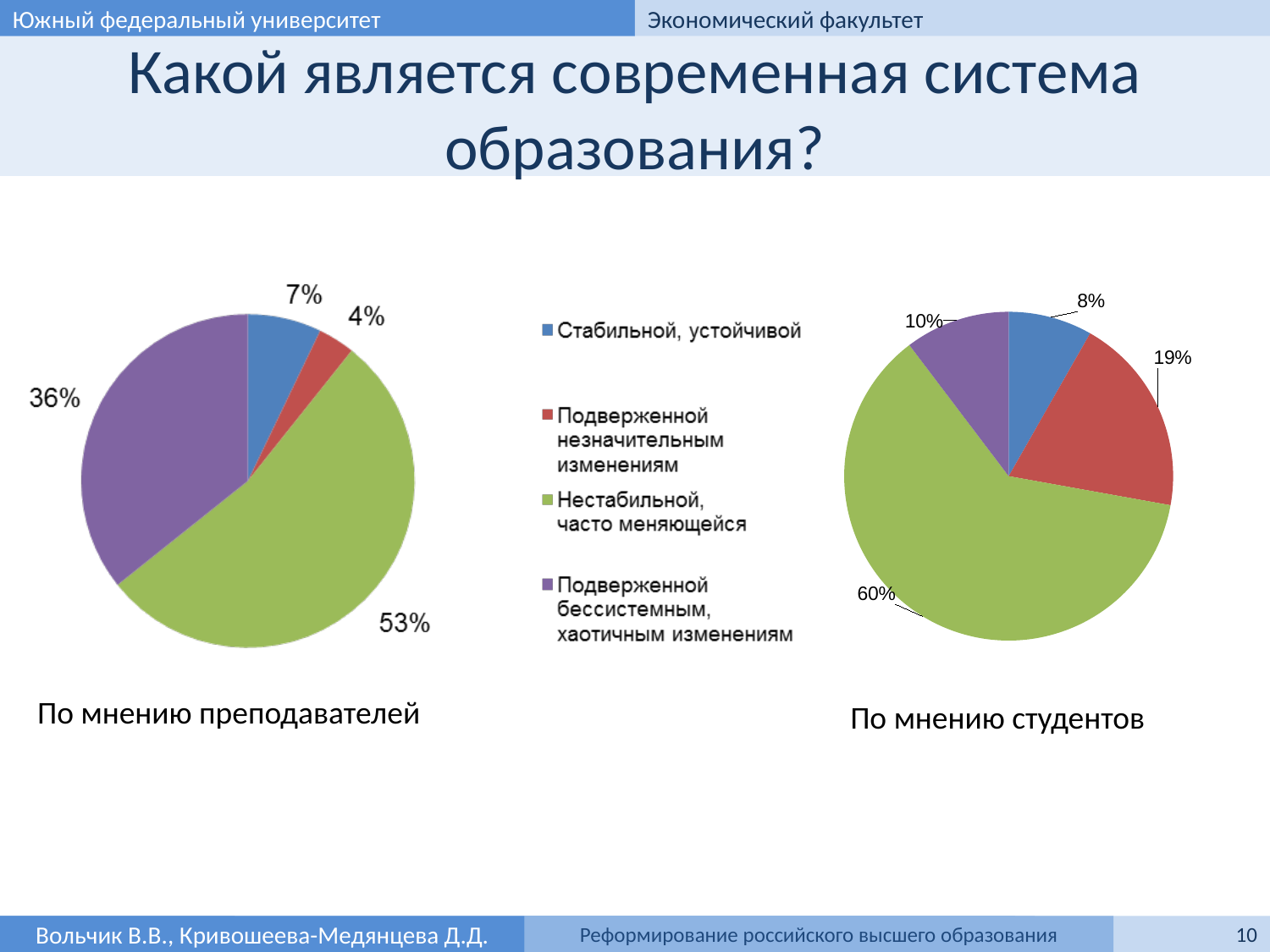
On the pie chart 'По мнению студентов', what share is labelled for the 'Подверженной бессистемным, хаотичным изменениям' slice? 10% What is the difference between the 'Нестабильной, часто меняющейся' share on the 'По мнению студентов' chart and on the 'По мнению преподавателей' chart? 7% What type of chart is used for 'По мнению преподавателей'? Pie chart How many slices does the pie chart 'По мнению студентов' have? 4 On the pie chart 'По мнению студентов', what share is labelled for the 'Подверженной незначительным изменениям' slice? 19% Which is larger: the 'Подверженной бессистемным, хаотичным изменениям' share on the 'По мнению преподавателей' chart or on the 'По мнению студентов' chart? По мнению преподавателей On the pie chart 'По мнению студентов', which category has the smallest slice? Стабильной, устойчивой On the pie chart 'По мнению преподавателей', which category has the smallest slice? Подверженной незначительным изменениям On the pie chart 'По мнению преподавателей', which category has the largest slice? Нестабильной, часто меняющейся On the pie chart 'По мнению преподавателей', what share is labelled for the 'Стабильной, устойчивой' slice? 7% How many entries does the legend between the two charts list? 4 On the pie chart 'По мнению преподавателей', what share is labelled for the 'Нестабильной, часто меняющейся' slice? 53%